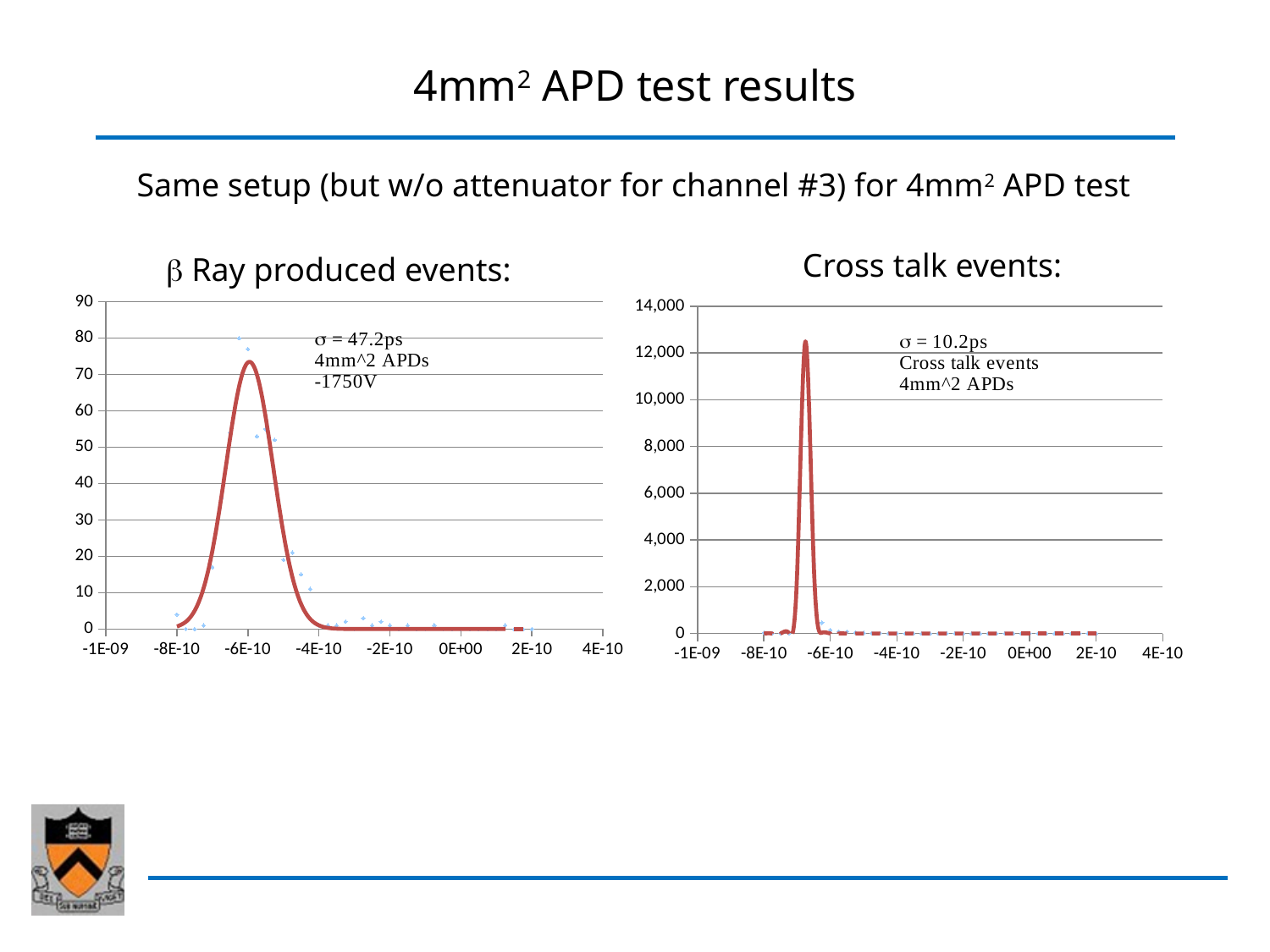
On the 'Cross talk events' chart, which is larger: the value near -7E-10 or the value near 2E-10? the value near -7E-10 What sigma value is annotated on the 'Cross talk events' chart? σ = 10.2ps On the 'β Ray produced events' chart, is the value at 0E+00 greater or less than 10? less On the 'β Ray produced events' chart, which is larger: the value near -6E-10 or the value near 0E+00? the value near -6E-10 On the 'Cross talk events' chart, is the peak of the fitted curve greater or less than 10,000? greater How many charts are shown on the slide? 2 On the 'β Ray produced events' chart, do the values rise or fall as x increases from -8E-10 to -6E-10? rise On the 'β Ray produced events' chart, is the peak of the fitted curve greater or less than 60? greater What sigma value is annotated on the 'β Ray produced events' chart? σ = 47.2ps What kind of chart is the 'β Ray produced events' chart on the left? scatter plot with a fitted curve On the 'β Ray produced events' chart, do the values rise or fall as x increases from -6E-10 to -4E-10? fall